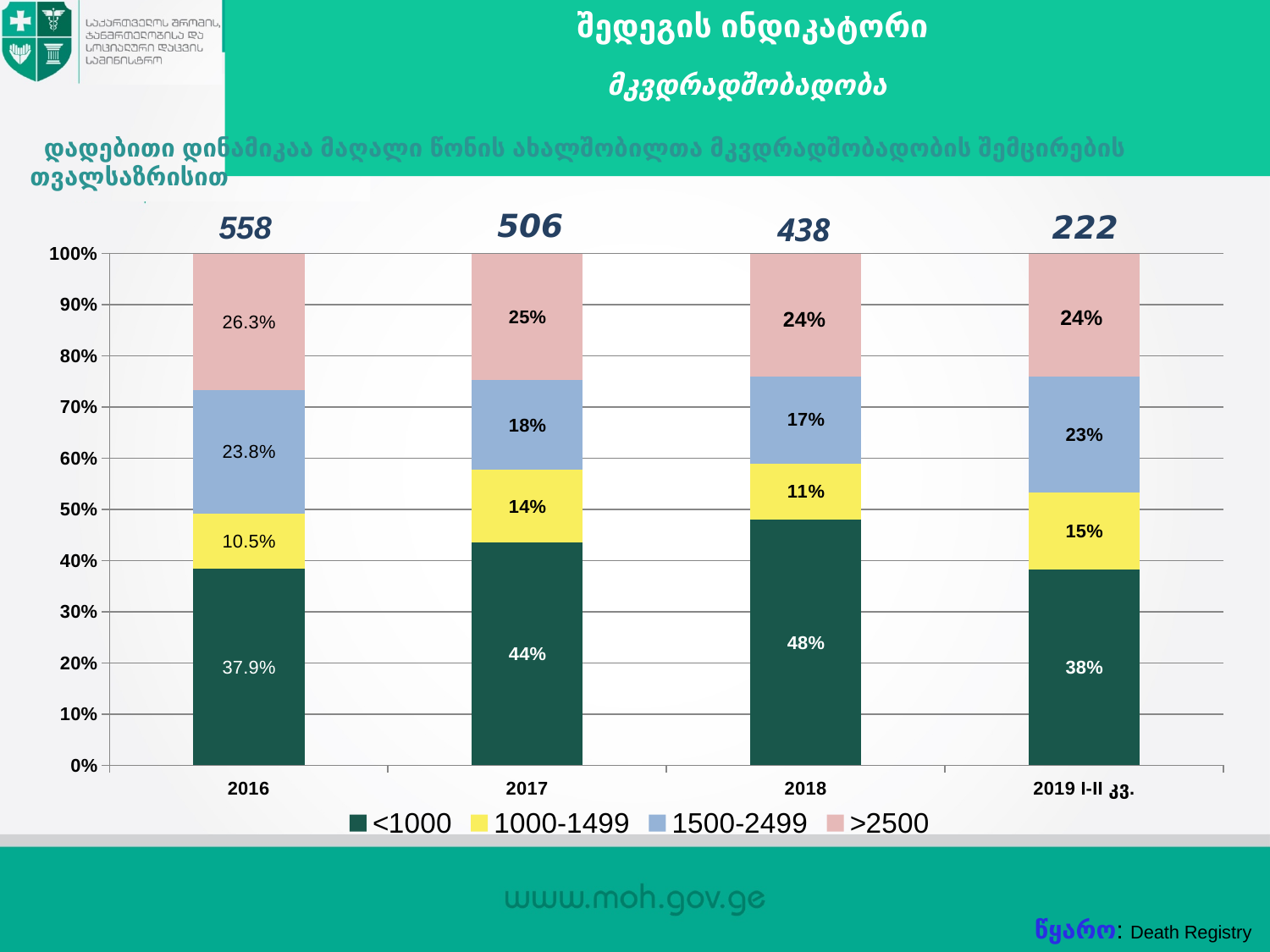
How many categories are shown on the x axis? 4 What is the value of the 1000-1499 series for 2018? 11% What is the difference between the <1000 values for 2018 and 2017? 4% How many series does the legend list? 4 Which category has the lowest value for the 1000-1499 series? 2016 Which year has the highest value for the <1000 series? 2018 What kind of chart is shown on the slide? stacked bar chart What is the value of the <1000 series for 2016? 37.9% What is the value of the >2500 series for 2017? 25% What number is printed above the 2019 I-II კვ. bar? 222 Which is larger: the 1500-2499 value for 2016 or for 2017? 2016 What is the value of the 1500-2499 series for 2019 I-II კვ.? 23%